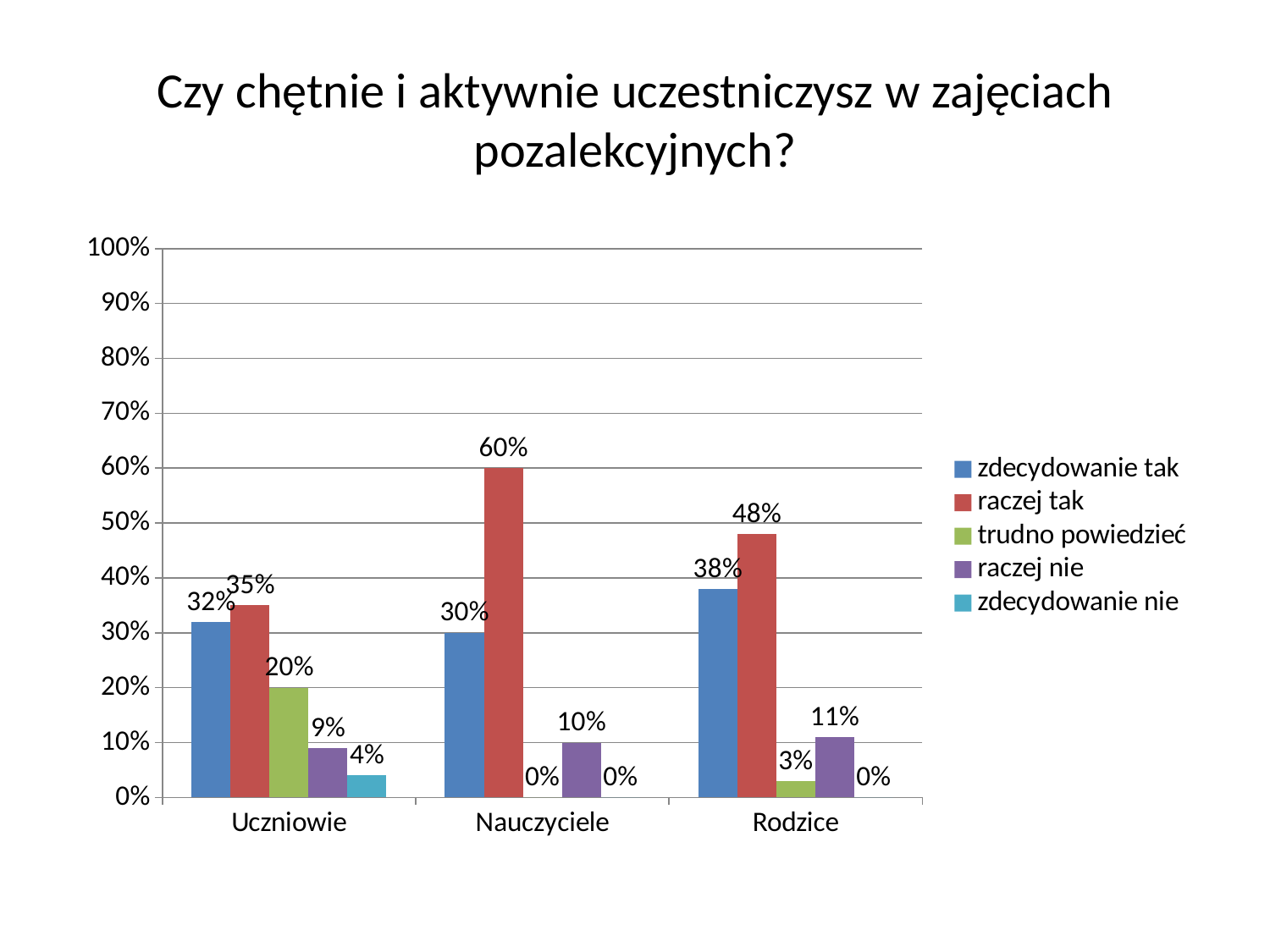
How many categories are shown on the x axis? 3 Which category has the lowest value for "zdecydowanie tak"? Nauczyciele What is the value for "zdecydowanie nie" in the Uczniowie category? 4% How many series does the legend list? 5 What kind of chart is shown on the slide? bar chart What is the difference between "raczej tak" and "zdecydowanie tak" in the Nauczyciele category? 30% Is the value for "raczej tak" in the Rodzice category greater or less than 40%? greater What is the value for "raczej tak" in the Nauczyciele category? 60% Which category has the highest value for "raczej tak"? Nauczyciele What is the value for "trudno powiedzieć" in the Uczniowie category? 20% What is the value for "zdecydowanie tak" in the Rodzice category? 38% Which is larger in the Rodzice category: "raczej nie" or "trudno powiedzieć"? raczej nie